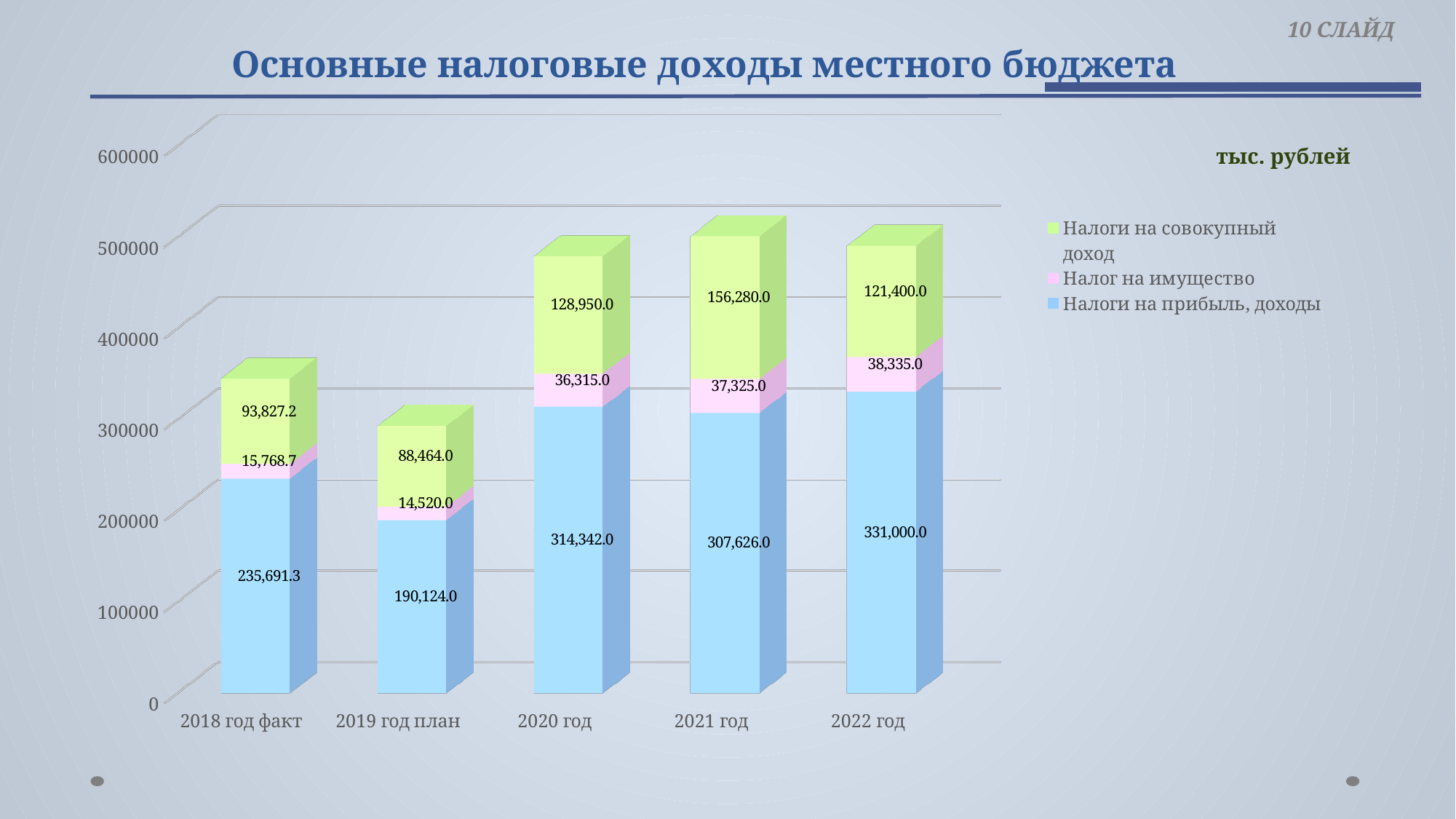
What is the value of "Налоги на совокупный доход" for 2022 год? 121,400.0 What is the value of "Налог на имущество" for 2018 год факт? 15,768.7 Which is larger: "Налоги на совокупный доход" in 2020 год or in 2022 год? 2020 год How many series does the legend list? 3 How many categories (years) are shown on the x axis? 5 What is the total of the stacked bar for 2019 год план? 293,108.0 What type of chart is shown on the slide? Stacked bar chart What is the difference between "Налоги на прибыль, доходы" in 2022 год and 2021 год? 23,374.0 In which year is "Налоги на совокупный доход" the highest? 2021 год What is the value of "Налоги на прибыль, доходы" for 2020 год? 314,342.0 In which category is "Налог на имущество" the lowest? 2019 год план What unit of measurement is indicated on the slide for the chart values? тыс. рублей